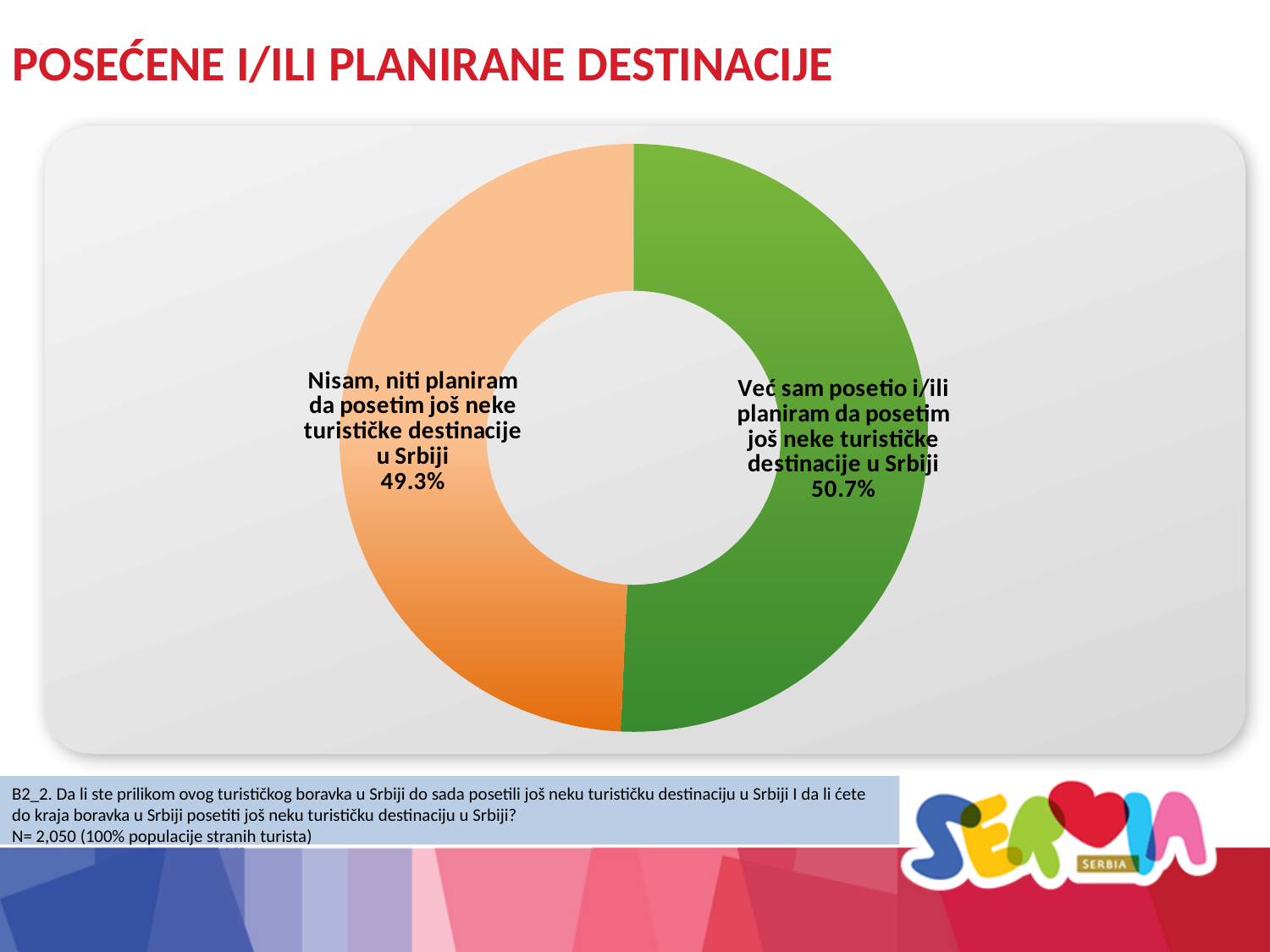
Is the share for "Već sam posetio i/ili planiram da posetim" larger or smaller than the share for "Nisam, niti planiram da posetim"? larger What percentage of respondents said they have already visited and/or plan to visit other tourist destinations in Serbia ("Već sam posetio i/ili planiram da posetim još neke turističke destinacije u Srbiji")? 50.7% Which category has the smaller share of the chart? Nisam, niti planiram da posetim još neke turističke destinacije u Srbiji What kind of chart is shown on the slide? Doughnut (pie) chart What percentage of respondents said they have not visited and do not plan to visit other tourist destinations in Serbia ("Nisam, niti planiram da posetim još neke turističke destinacije u Srbiji")? 49.3% What is the sample size (N) stated below the chart? 2,050 What colour is the slice for "Nisam, niti planiram da posetim još neke turističke destinacije u Srbiji"? Orange What share of the chart does the green slice represent? 50.7% What is the difference in percentage points between the two categories shown in the chart? 1.4 Which category has the larger share of the chart? Već sam posetio i/ili planiram da posetim još neke turističke destinacije u Srbiji How many categories are shown in the chart? 2 What is the title of the slide containing the chart? POSEĆENE I/ILI PLANIRANE DESTINACIJE